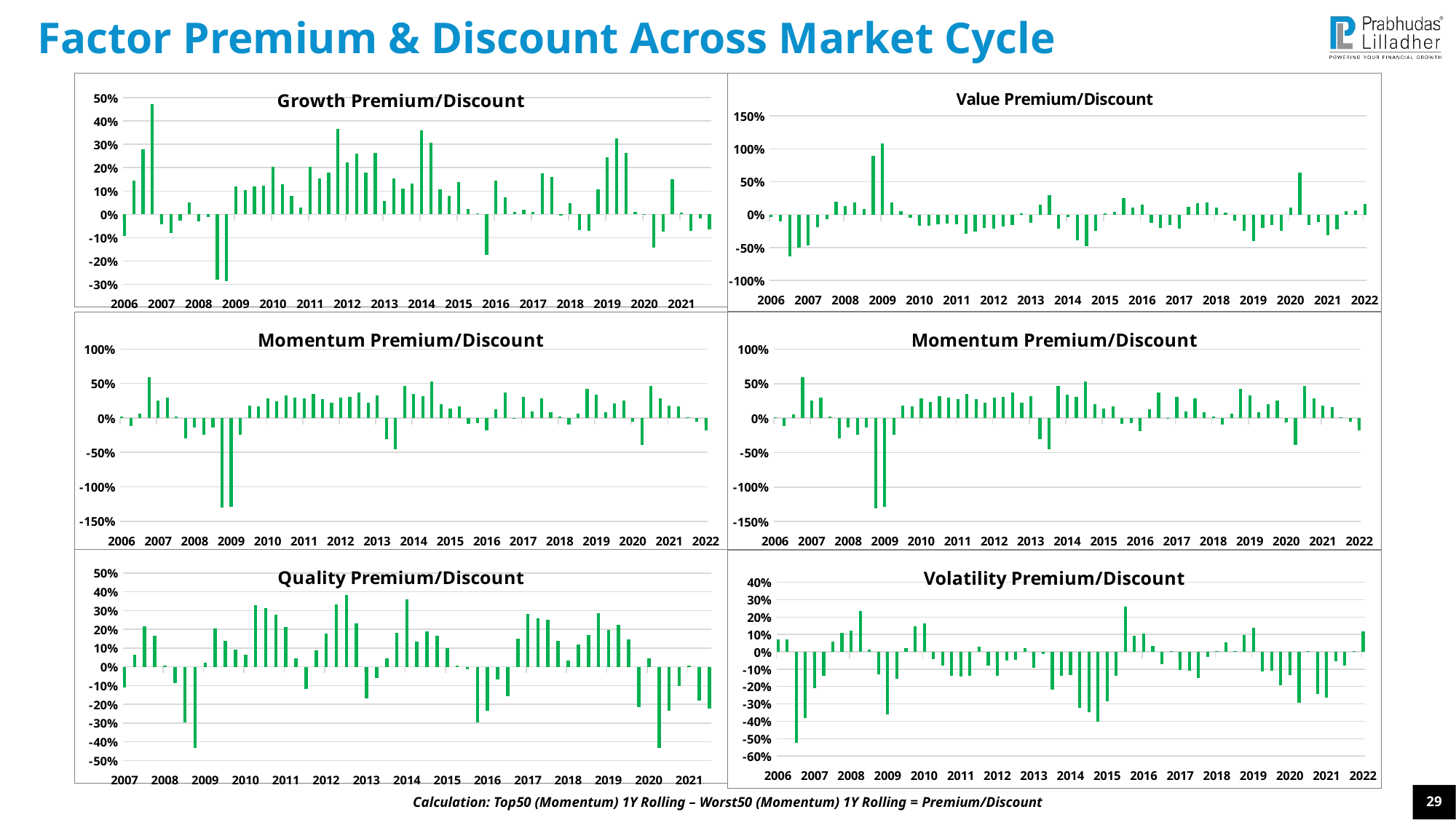
How many charts are shown on the slide? 6 What is the title of the top-left chart? Growth Premium/Discount In the middle-left Momentum Premium/Discount chart, which year has the lowest bars? 2009 In the Quality Premium/Discount chart, is the highest bar in 2012 greater or less than 30%? greater What kind of chart is the Growth Premium/Discount chart? bar chart In the middle-left Momentum Premium/Discount chart, is the lowest bar in 2009 greater or less than -100%? less In the Value Premium/Discount chart, is the highest bar in 2009 greater or less than 100%? greater In the Value Premium/Discount chart, which year has the highest bar? 2009 What is the title of the bottom-right chart? Volatility Premium/Discount